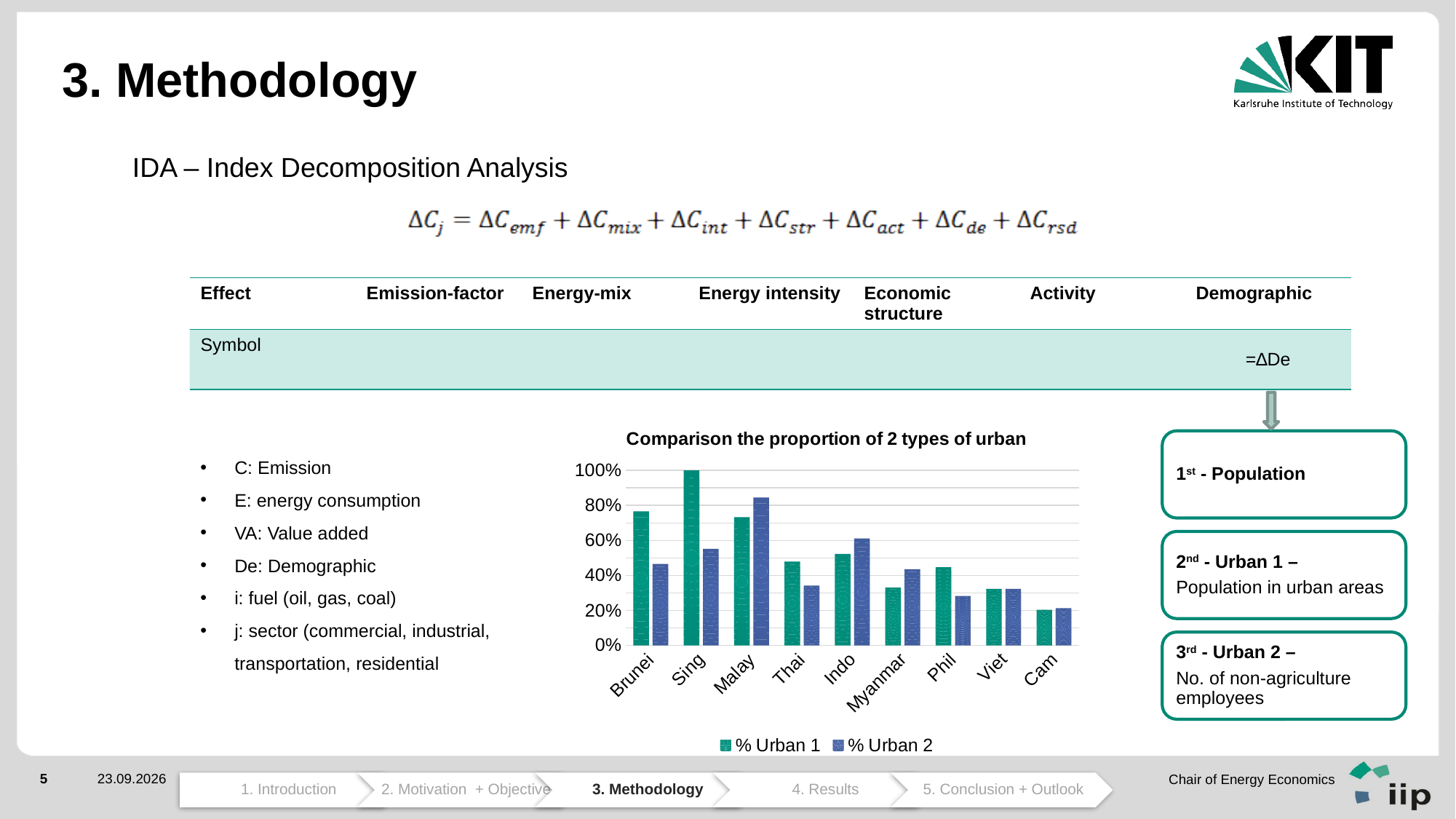
Is the % Urban 2 value for Malay greater or less than 60%? greater For Indo, which series has the larger value, % Urban 1 or % Urban 2? % Urban 2 For Brunei, which series has the larger value, % Urban 1 or % Urban 2? % Urban 1 Is the % Urban 1 value for Brunei greater or less than 60%? greater How many series does the chart legend list? 2 Which country has the highest % Urban 2 value? Malay Which country has the lowest % Urban 1 value? Cam How many countries are shown on the x axis of the chart? 9 Is the % Urban 2 value for Thai greater or less than 40%? less Which country has the highest % Urban 1 value? Sing What type of chart is shown on the slide? bar chart What is the title of the chart on the slide? Comparison the proportion of 2 types of urban